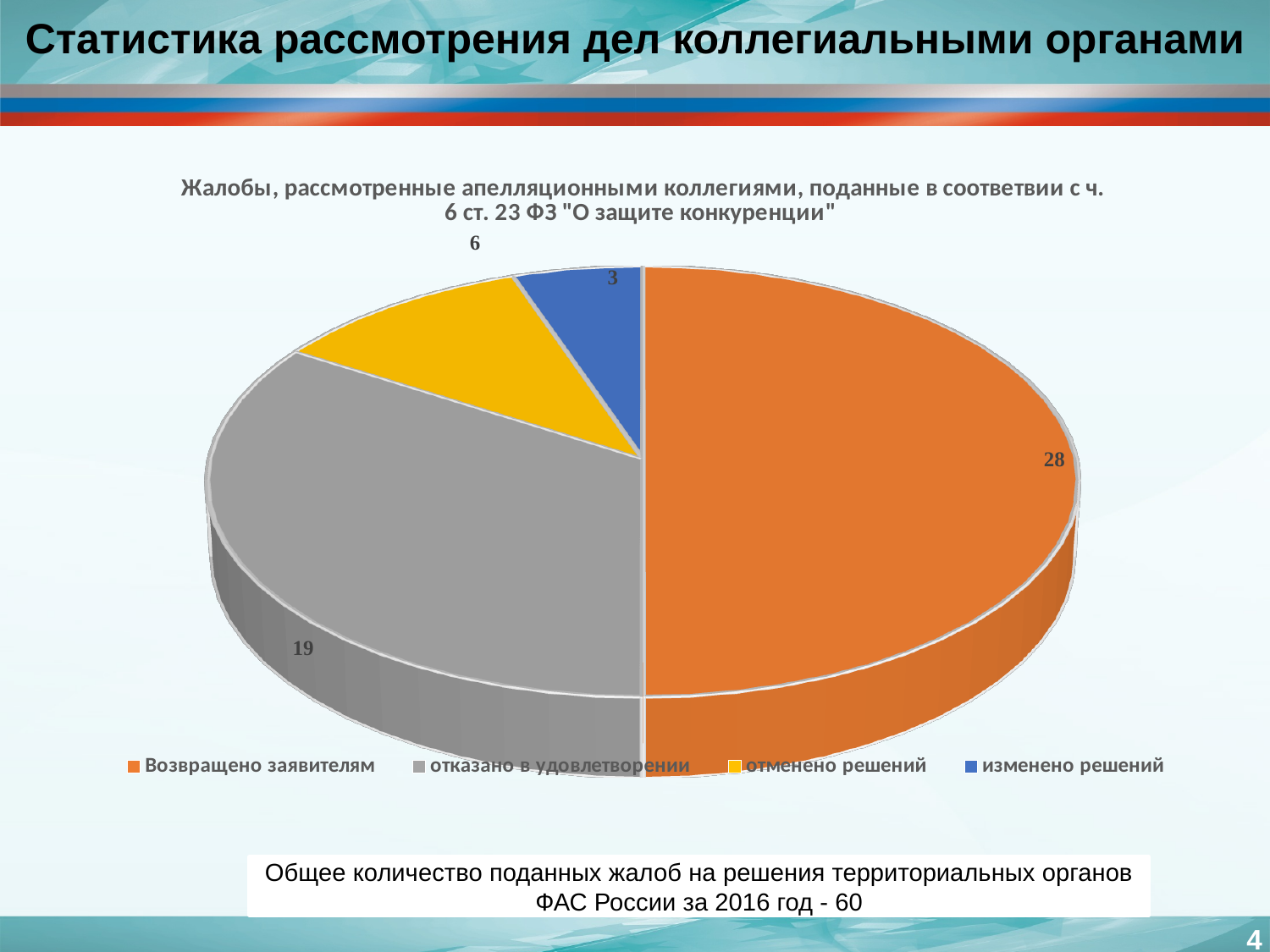
What is the value for "отменено решений"? 6 Which is larger, the value for "отменено решений" or the value for "изменено решений"? отменено решений Which category has the smallest slice of the pie? изменено решений How many categories does the pie chart show? 4 What colour is the slice for "отказано в удовлетворении"? gray What is the difference between the values for "Возвращено заявителям" and "отказано в удовлетворении"? 9 What is the value for "отказано в удовлетворении"? 19 What share of the pie does "Возвращено заявителям" represent? 50% What is the value for "Возвращено заявителям"? 28 What kind of chart is shown on the slide? pie chart Which category has the largest slice of the pie? Возвращено заявителям What is the value for "изменено решений"? 3